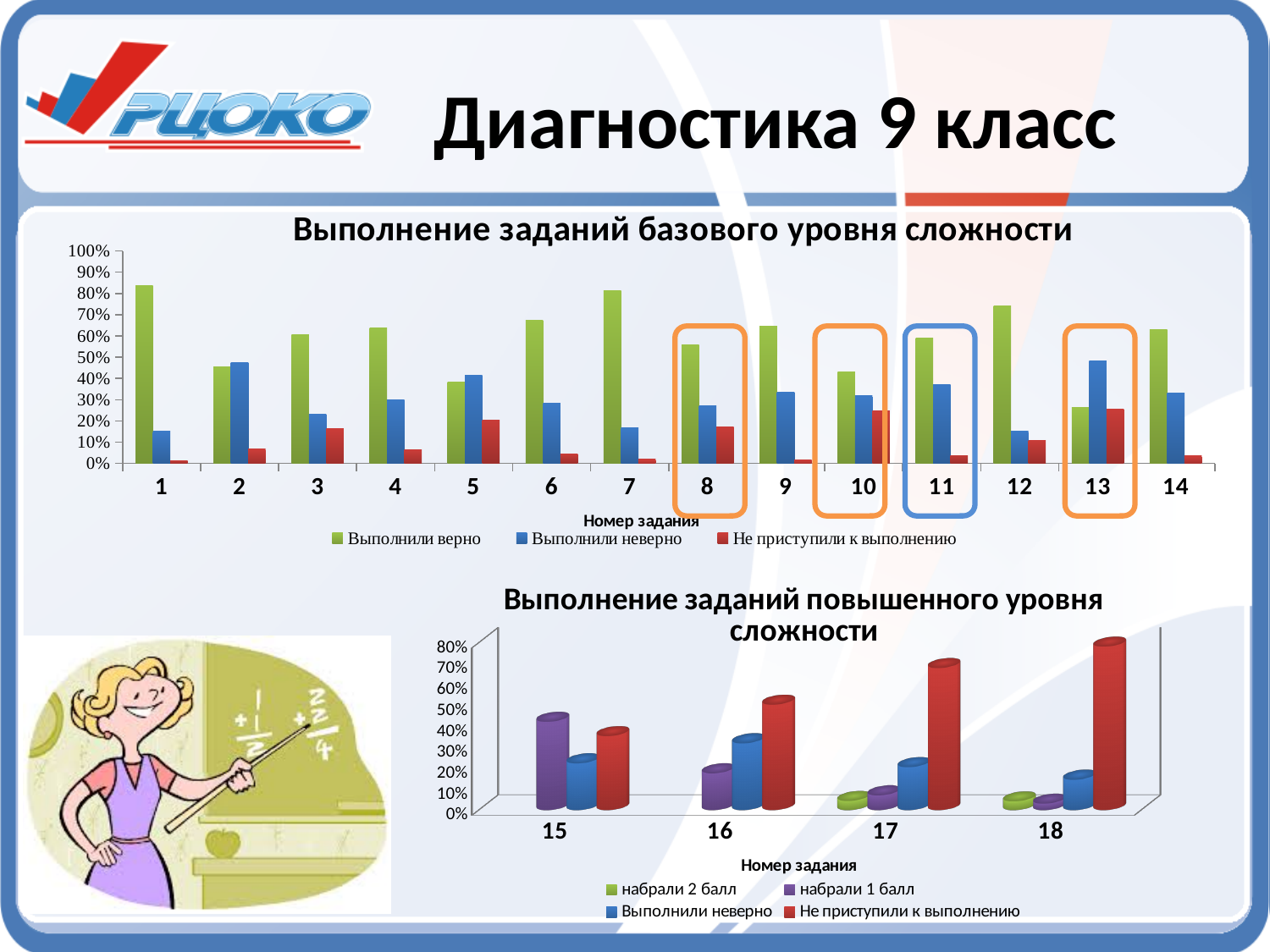
What type of chart is the top chart titled "Выполнение заданий базового уровня сложности"? bar chart In the top chart "Выполнение заданий базового уровня сложности", is the "Выполнили неверно" value for task 3 greater or less than 30%? less In the bottom chart "Выполнение заданий повышенного уровня сложности", which task number has the highest value for "Не приступили к выполнению"? 18 In the top chart "Выполнение заданий базового уровня сложности", is the "Выполнили верно" value for task 13 greater or less than 30%? less How many series does the legend of the top chart "Выполнение заданий базового уровня сложности" list? 3 How many series does the legend of the bottom chart "Выполнение заданий повышенного уровня сложности" list? 4 In the top chart "Выполнение заданий базового уровня сложности", is the "Выполнили верно" value for task 7 greater or less than 70%? greater In the top chart "Выполнение заданий базового уровня сложности", which is larger for task 5: "Выполнили верно" or "Не приступили к выполнению"? Выполнили верно How many task numbers are shown on the x axis of the top chart "Выполнение заданий базового уровня сложности"? 14 In the bottom chart "Выполнение заданий повышенного уровня сложности", does the value for "Не приступили к выполнению" rise or fall from task 15 to task 18? rise In the top chart "Выполнение заданий базового уровня сложности", which task number has the lowest value for "Выполнили верно"? 13